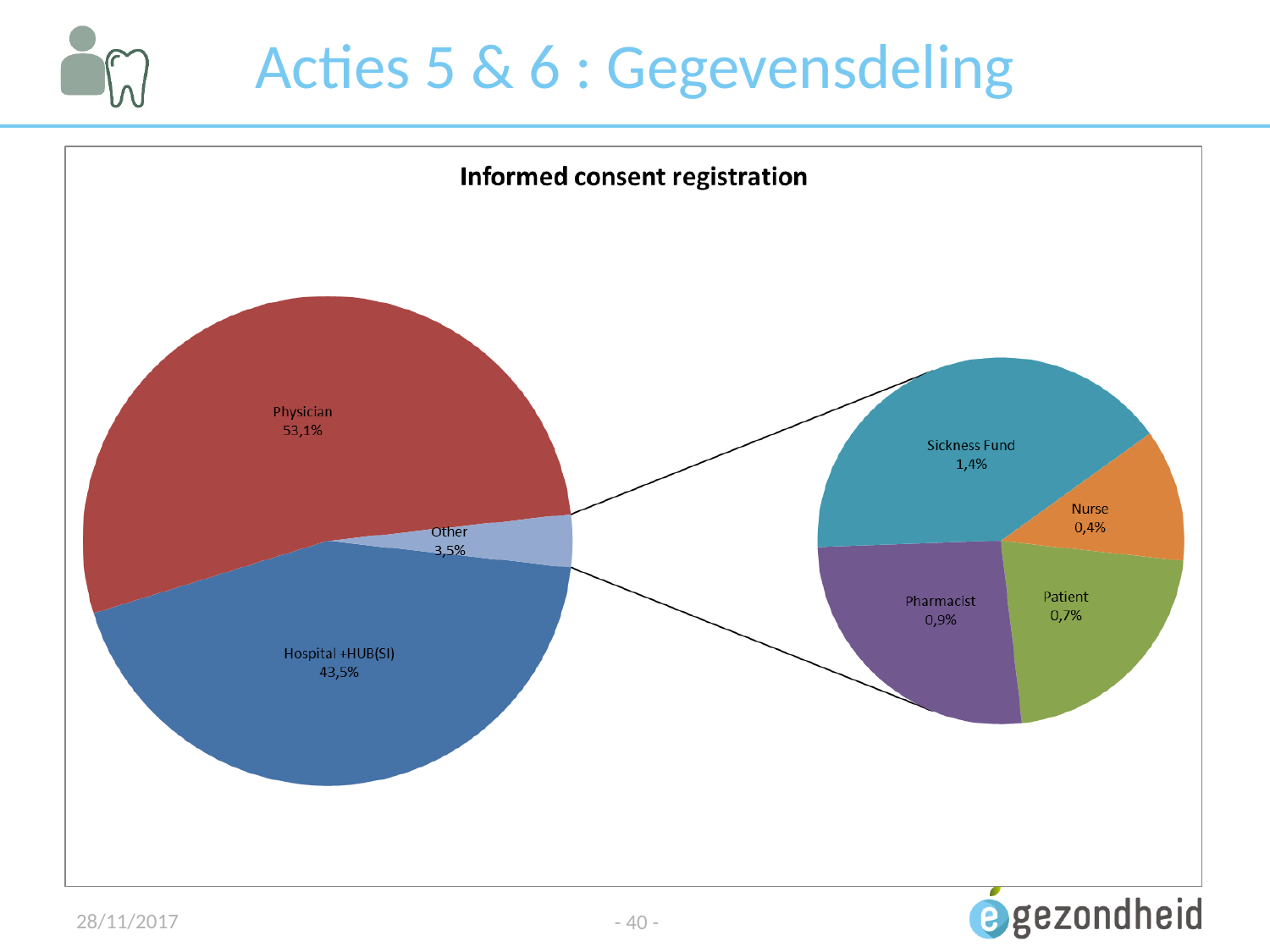
What share is attributed to Hospital +HUB(SI)? 43,5% Which has a larger share, Pharmacist or Patient? Pharmacist What share of informed consent registrations is attributed to Physician? 53,1% What share is attributed to Nurse? 0,4% What kind of chart is shown on the slide? Pie chart What is the title of the chart? Informed consent registration What share is attributed to Sickness Fund in the breakdown pie? 1,4% How many percentage points larger is the Physician share than the Hospital +HUB(SI) share? 9,6 Which category has the smallest share in the chart? Nurse What percentage does the Other slice represent in the main pie? 3,5% Which category has the largest share in the chart? Physician How many slices are in the smaller breakdown pie on the right? 4